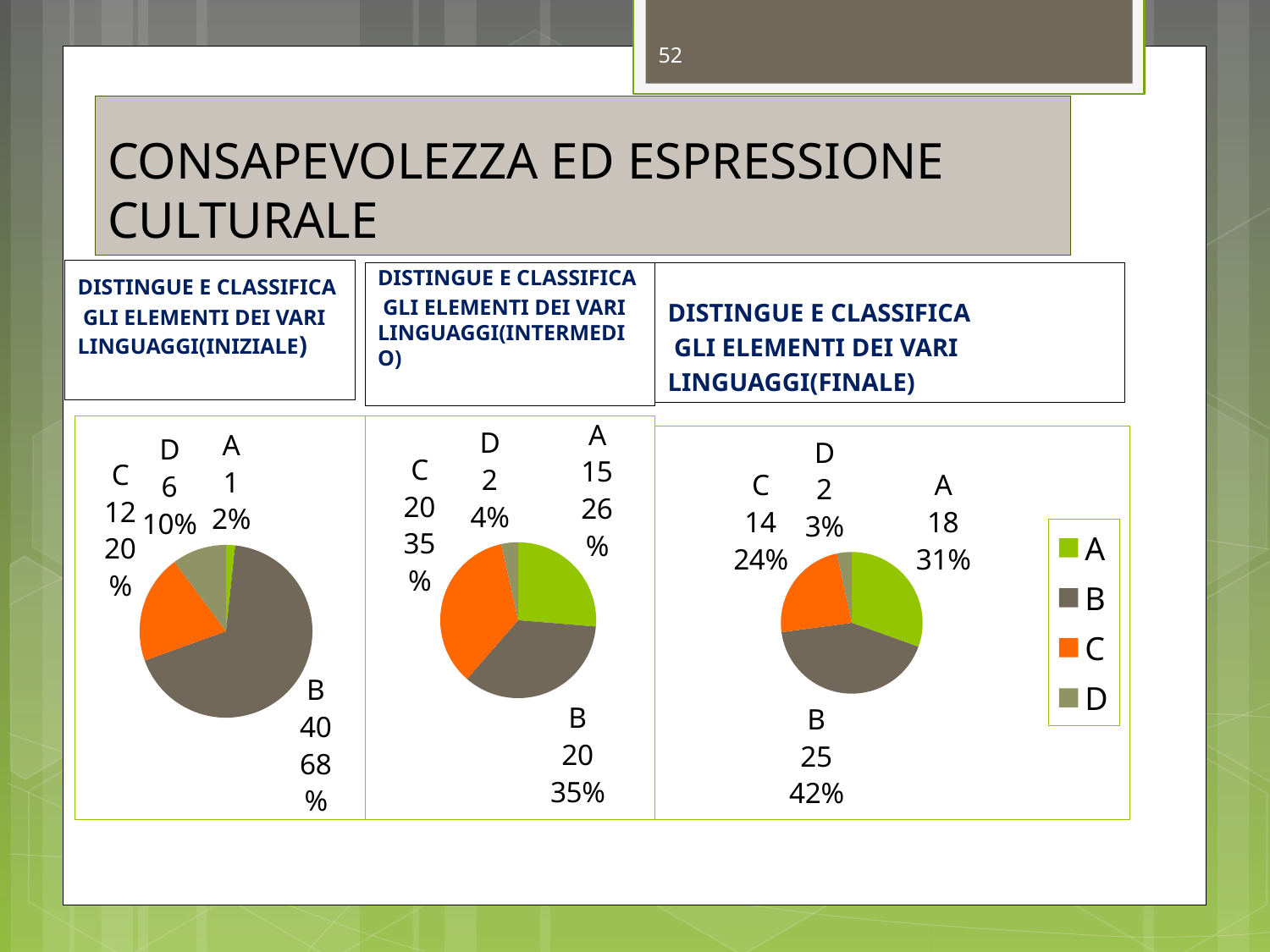
In the middle pie chart (INTERMEDIO), what is the value for category A? 15 In the right pie chart (FINALE), what is the value for category C? 14 In the right pie chart (FINALE), what share of the pie does category B represent? 42% In the left pie chart (INIZIALE), which category has the smallest slice? A What kind of chart is used in the left panel (INIZIALE)? Pie chart In the middle pie chart (INTERMEDIO), what share of the pie does category D represent? 4% In the right pie chart (FINALE), which category has the largest slice? B In the left pie chart (INIZIALE), what is the value for category B? 40 How many categories does the legend next to the right pie chart (FINALE) list? 4 In the middle pie chart (INTERMEDIO), what is the difference between the values for B and A? 5 In the left pie chart (INIZIALE), what share of the pie does category C represent? 20% In the right pie chart (FINALE), which is larger, the value for A or the value for C? A